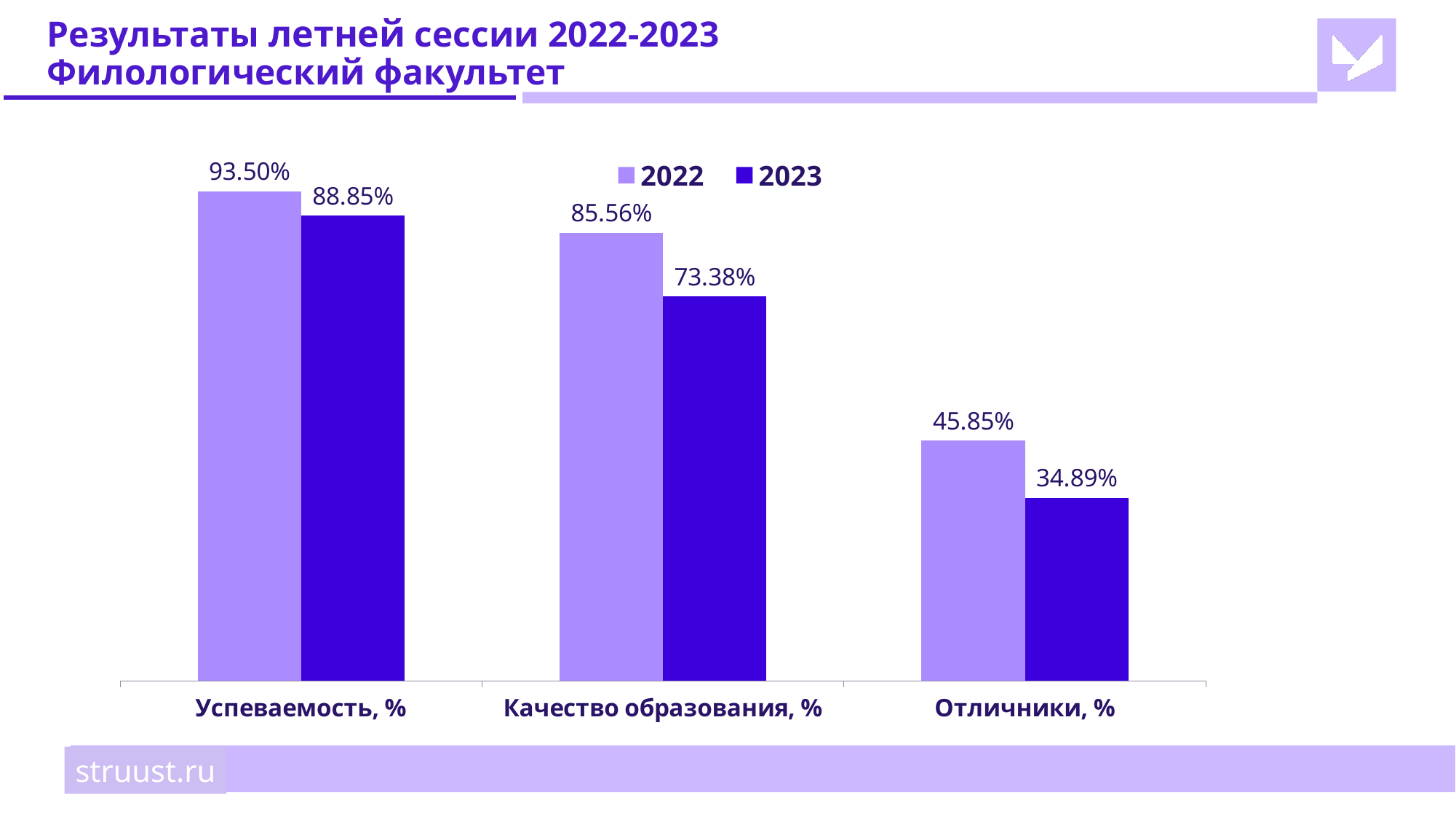
What is the 2023 value for Отличники, %? 34.89% Which category has the lowest 2023 value? Отличники, % What is the difference between the 2022 and 2023 values for Успеваемость, %? 4.65% Which category has the highest 2022 value? Успеваемость, % How many categories are shown on the x axis? 3 Which is larger for Отличники, %: the 2022 value or the 2023 value? 2022 What is the difference between the 2022 and 2023 values for Качество образования, %? 12.18% How many series does the legend list? 2 What is the 2023 value for Качество образования, %? 73.38% What is the 2022 value for Отличники, %? 45.85% What is the 2022 value for Успеваемость, %? 93.50% What kind of chart is shown on the slide? Bar chart